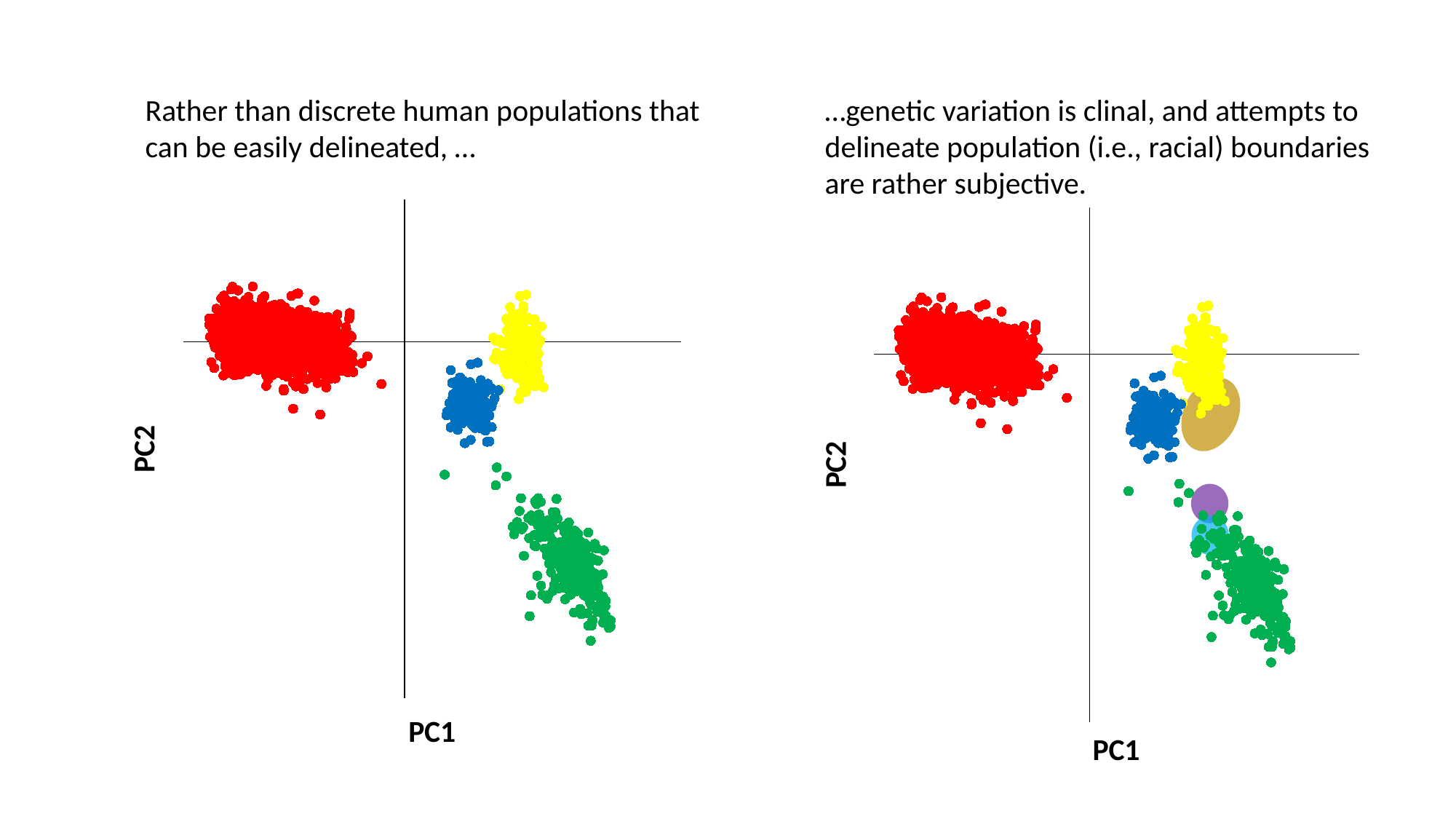
In the right chart, which coloured cluster lies furthest to the right along PC1? Green What kind of chart is shown on the left side of the slide? Scatter plot In the left chart, which coloured cluster extends lowest on the PC2 axis? Green In the left chart, which coloured cluster lies entirely to the left of the vertical axis? Red In the right chart, is the blue cluster located to the left or to the right of the yellow cluster? Left What kind of chart is shown on the right side of the slide? Scatter plot In the left chart, is the red cluster larger or smaller in extent than the blue cluster? Larger In the left chart, what is the label of the horizontal axis? PC1 In the left chart, what is the label of the vertical axis? PC2 In the left chart, how many distinct coloured clusters of points are plotted? 4